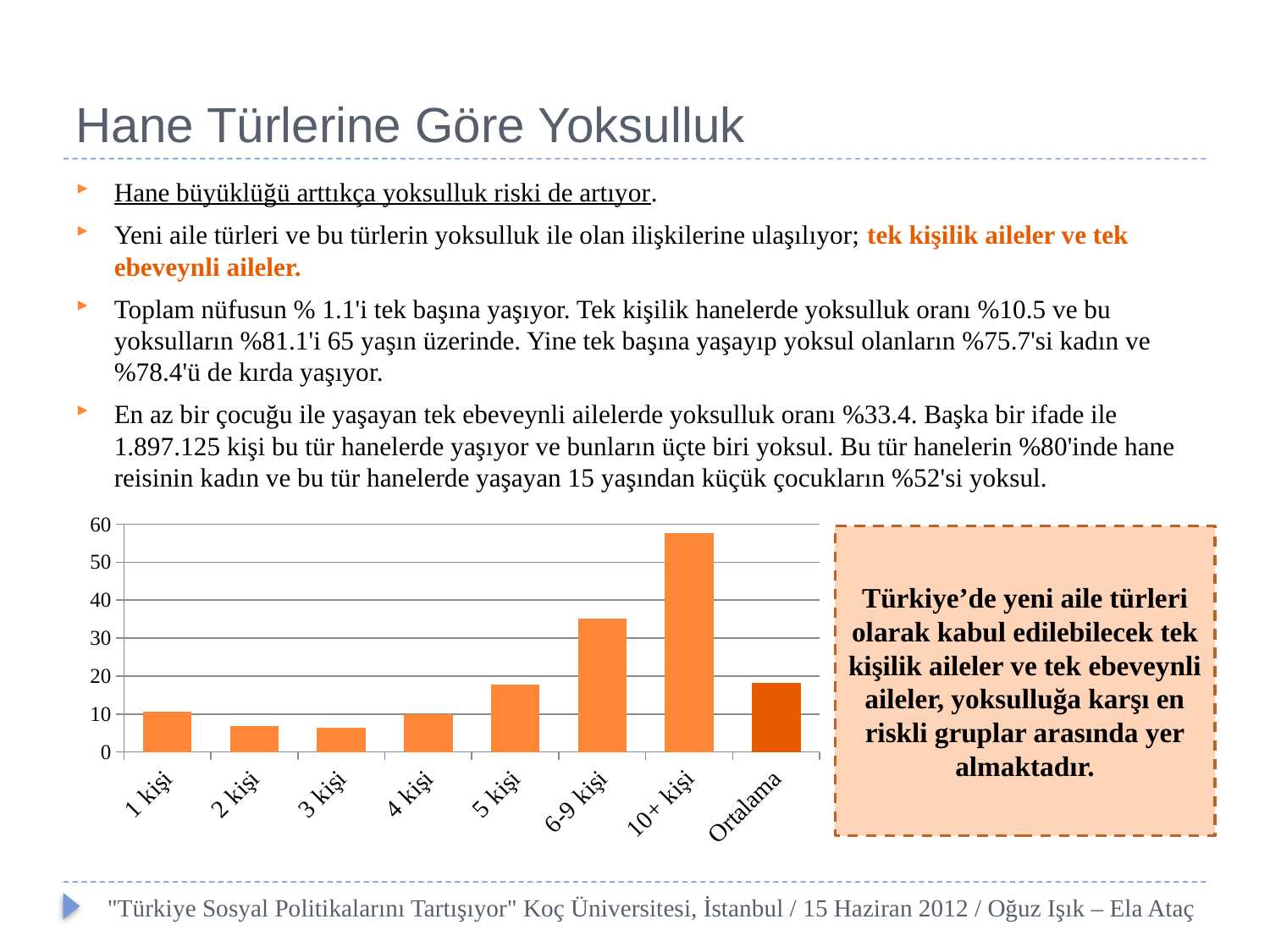
Which category has the highest value in the chart? 10+ kişi Which is larger, the value for 5 kişi or the value for 2 kişi? 5 kişi Is the value for 2 kişi greater or less than 10? less How many categories are shown on the x axis of the chart? 8 Do the values rise or fall from 3 kişi to 10+ kişi along the x axis? rise Which is larger, the value for 10+ kişi or the value for 6-9 kişi? 10+ kişi Is the value for 6-9 kişi greater or less than 30? greater Is the value for 10+ kişi greater or less than 50? greater Which bar in the chart is drawn in a darker orange than the others? Ortalama What kind of chart is shown on the slide? bar chart